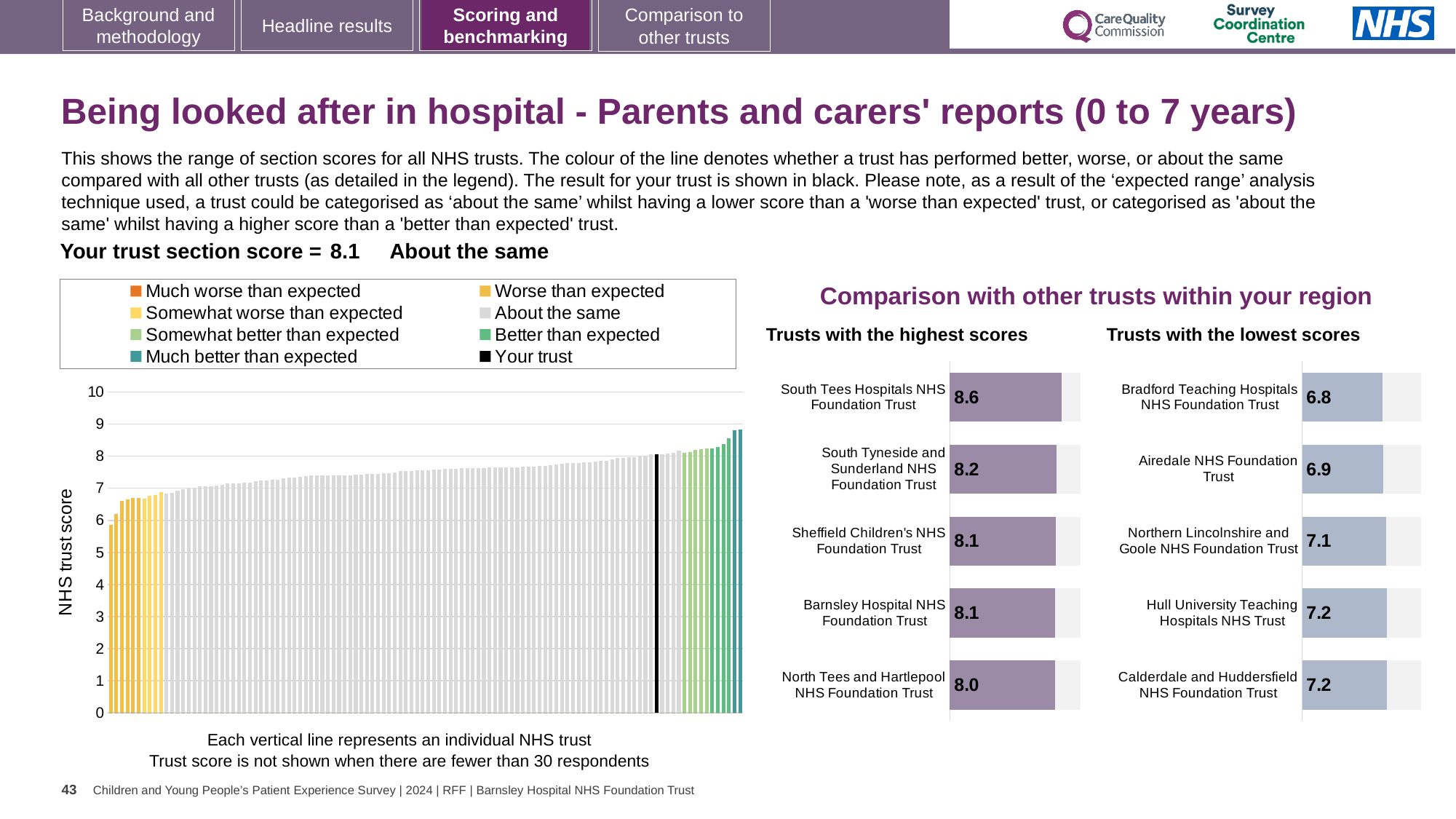
What is your trust's section score shown on the slide? 8.1 In the NHS trust score chart on the left, is the value of the leftmost (lowest) bar greater or less than 7? less In the 'Trusts with the lowest scores' chart, which trust has the lowest score? Bradford Teaching Hospitals NHS Foundation Trust In the 'Trusts with the lowest scores' chart, what is the score for Airedale NHS Foundation Trust? 6.9 How many entries does the legend of the NHS trust score chart on the left list? 8 In the 'Trusts with the highest scores' chart, what is the difference between the scores of South Tees Hospitals NHS Foundation Trust and North Tees and Hartlepool NHS Foundation Trust? 0.6 In the 'Trusts with the lowest scores' chart, which has the higher score: Bradford Teaching Hospitals NHS Foundation Trust or Northern Lincolnshire and Goole NHS Foundation Trust? Northern Lincolnshire and Goole NHS Foundation Trust What kind of chart is the NHS trust score chart on the left of the slide? Bar chart In the 'Trusts with the highest scores' chart, what is the score for South Tees Hospitals NHS Foundation Trust? 8.6 How many trusts are shown in the 'Trusts with the highest scores' chart? 5 In the NHS trust score chart on the left, do the values rise or fall from left to right? Rise In the 'Trusts with the highest scores' chart, which trust has the highest score? South Tees Hospitals NHS Foundation Trust